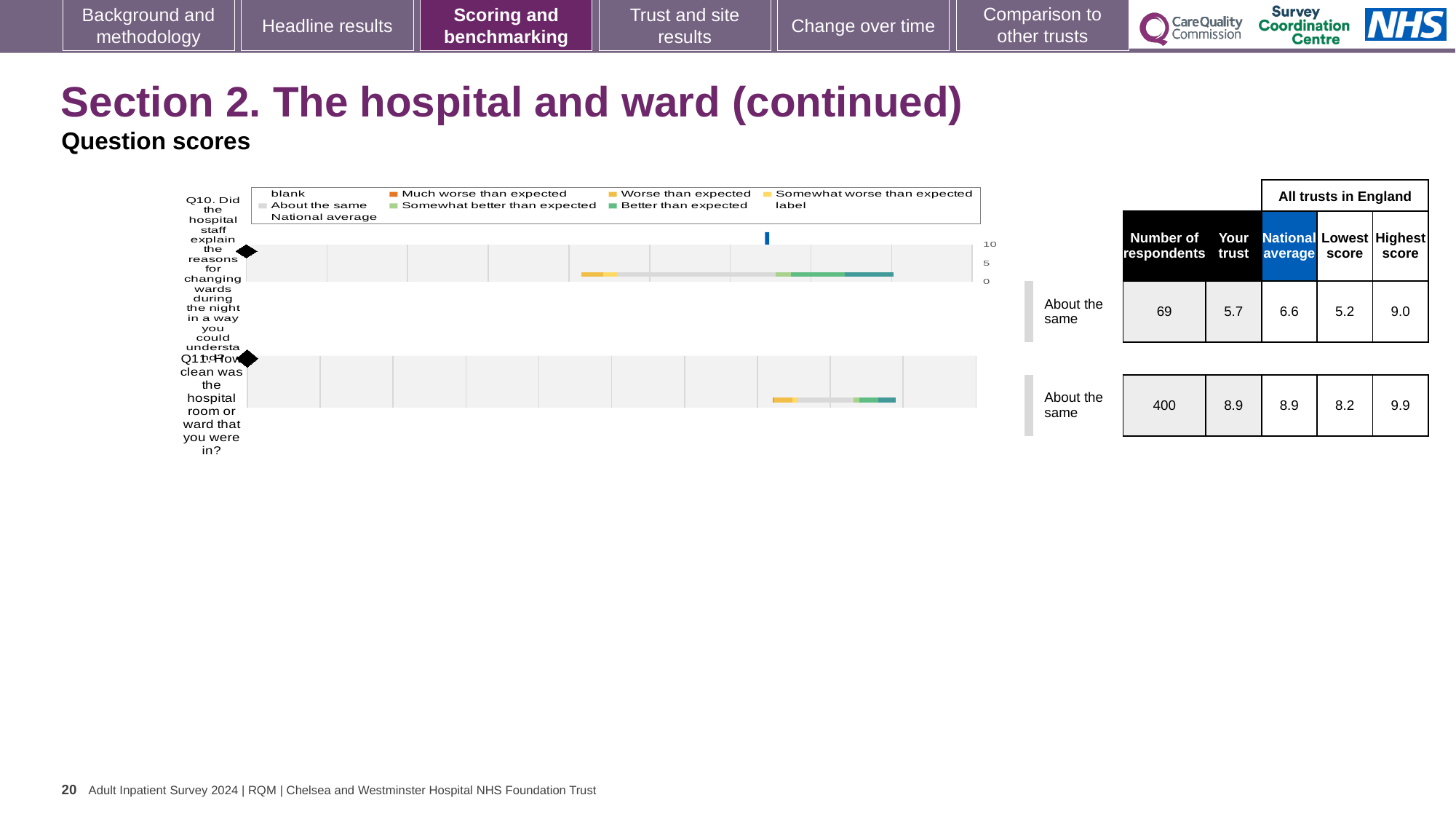
What is the national average score for Q10? 6.6 How many respondents answered Q11 (how clean was the hospital room or ward)? 400 What is the lowest score across all trusts in England for Q10? 5.2 What is the 'Your trust' score for Q10 (explaining reasons for changing wards during the night)? 5.7 What kind of chart is used to show the question scores for Q10 and Q11? bar chart What benchmark category is shown for Q11? About the same By how much does the national average exceed the trust's score for Q10? 0.9 How many questions are plotted on the slide's charts? 2 Which question has the higher 'Your trust' score, Q10 or Q11? Q11 What is the highest score across all trusts in England for Q11? 9.9 What is the difference between the highest and lowest scores for Q10? 3.8 What is the maximum value shown on the score axis of the charts? 10